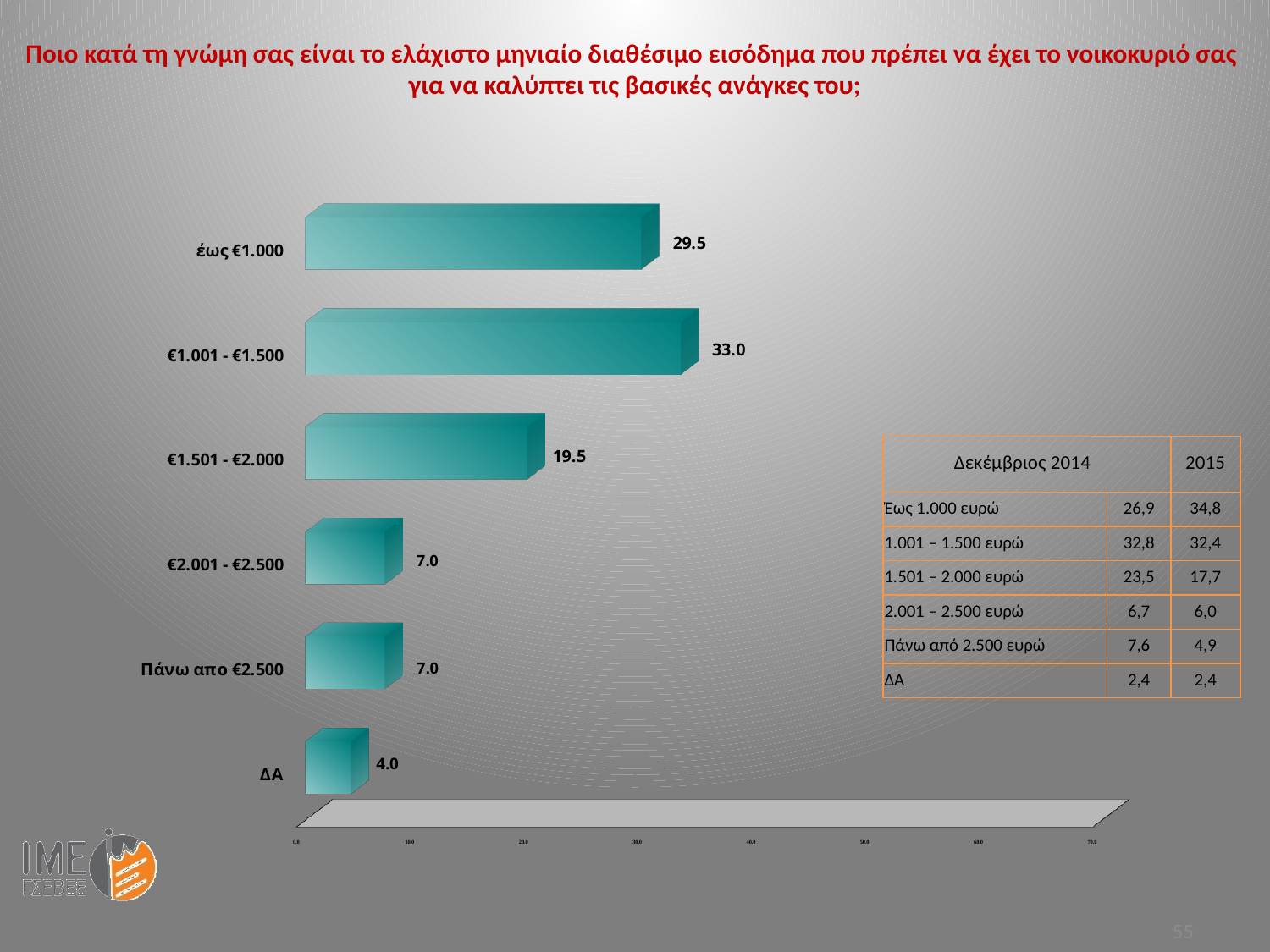
What is the value for the category 'έως €1.000'? 29.5 Which category has the highest value in the bar chart? €1.001 - €1.500 What is the difference between the values for 'έως €1.000' and '€1.501 - €2.000'? 10.0 How many categories are shown in the bar chart? 6 Which two categories in the bar chart share the same value of 7.0? €2.001 - €2.500 and Πάνω απο €2.500 What is the value for the category 'ΔΑ'? 4.0 Which is larger, the value for 'έως €1.000' or the value for '€1.501 - €2.000'? έως €1.000 Which category has the lowest value in the bar chart? ΔΑ What kind of chart is shown on the slide? bar chart What is the value for the category '€1.501 - €2.000'? 19.5 What is the difference between the values for '€1.001 - €1.500' and 'έως €1.000'? 3.5 What is the value for the category '€1.001 - €1.500'? 33.0